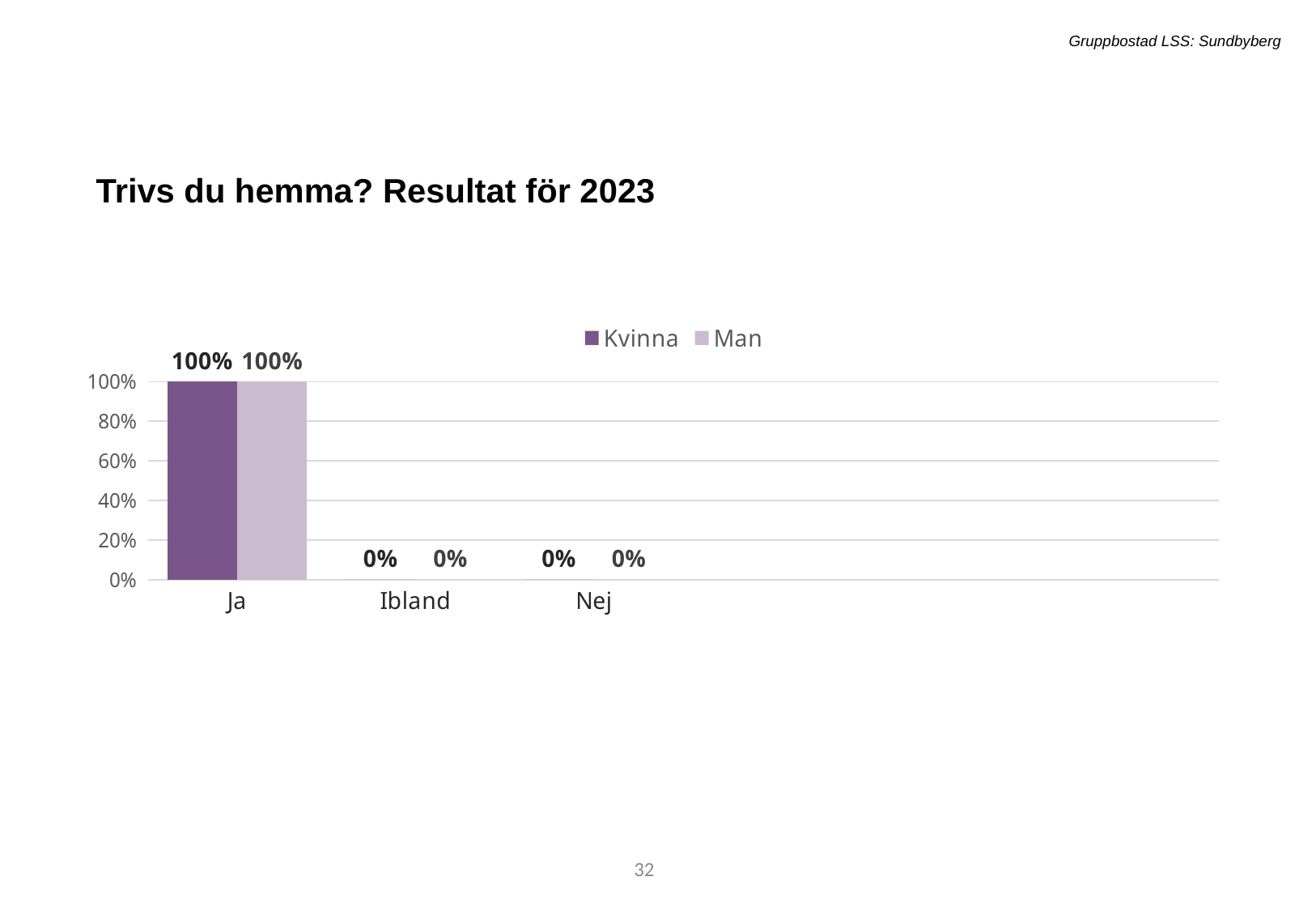
Is the value for Kvinna in the Ja category greater or less than 80%? greater Which is larger: the Man value for Ja or the Man value for Ibland? Ja Which series is shown in the darker purple colour? Kvinna How many series does the legend list? 2 What is the value for Man in the Ibland category? 0% What is the difference between the Kvinna value for Ja and the Kvinna value for Nej? 100% How many categories are shown on the x axis? 3 What is the value for Kvinna in the Nej category? 0% What is the title of the chart on the slide? Trivs du hemma? Resultat för 2023 What is the value for Kvinna in the Ja category? 100% Which category has the highest value for Man? Ja What kind of chart is shown on the slide? bar chart